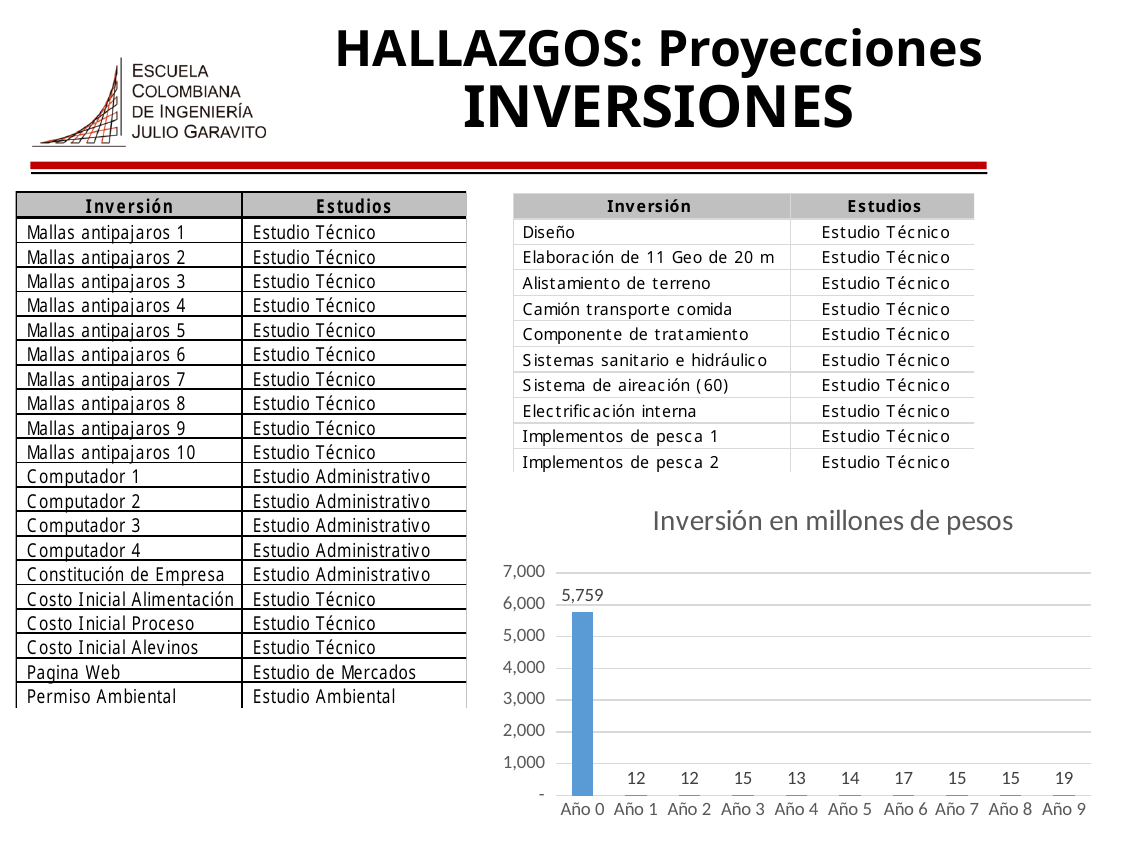
What is the value for Año 4 in the chart? 13 Which year has the highest value in the chart? Año 0 What is the difference between the values for Año 9 and Año 1 in the chart? 7 What type of chart is shown on the slide? bar chart What is the value for Año 0 in the chart? 5,759 How many categories (years) are shown on the x axis of the chart? 10 What is the title of the chart on the slide? Inversión en millones de pesos What is the value for Año 6 in the chart? 17 Which is larger in the chart, the value for Año 6 or the value for Año 3? Año 6 What is the value for Año 9 in the chart? 19 What is the difference between the values for Año 0 and Año 9 in the chart? 5,740 Is the value for Año 0 greater or less than 5,000? greater